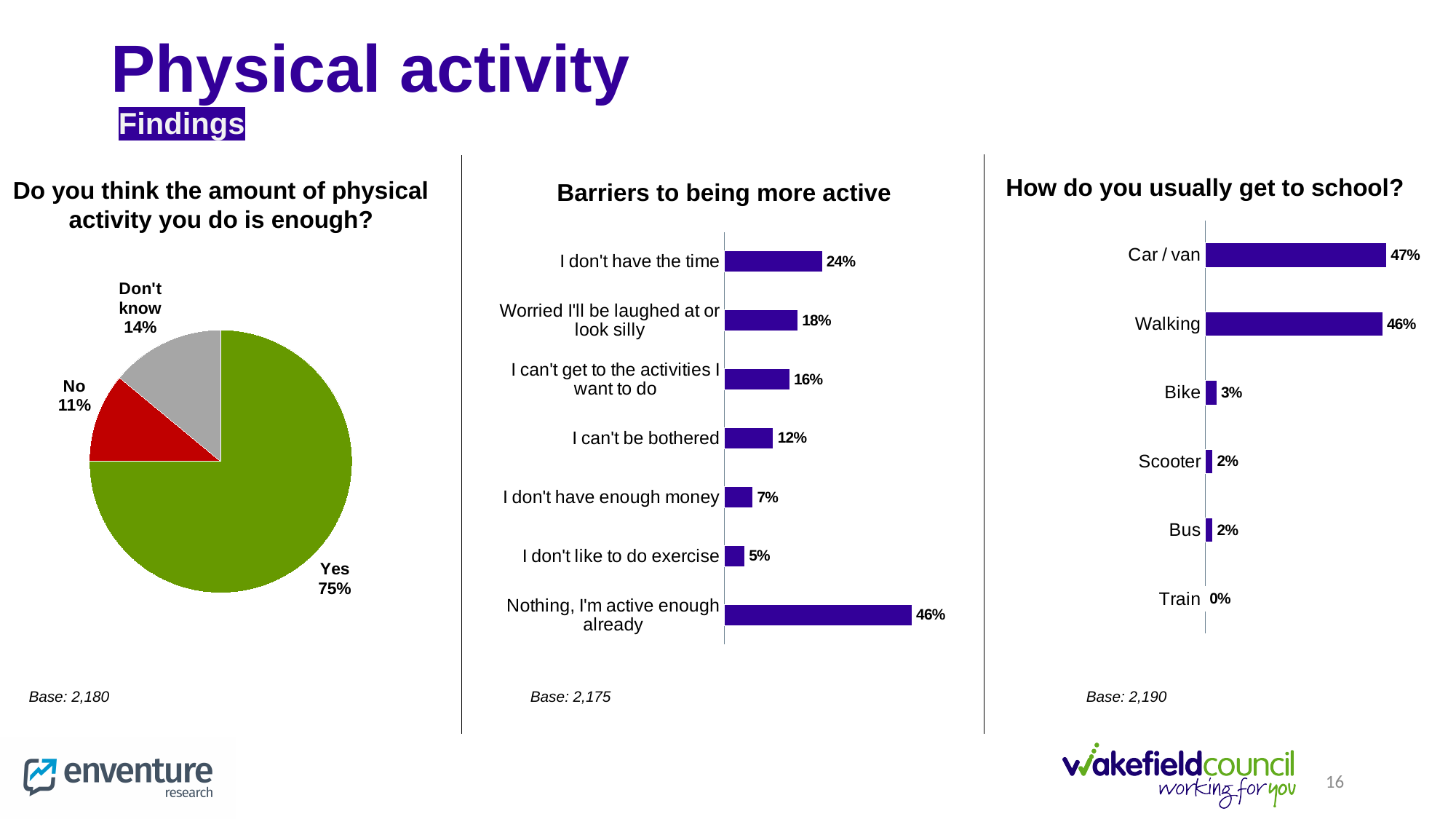
In the 'Barriers to being more active' chart, what is the difference between 'I don't have the time' and 'I can't be bothered'? 12% In the 'Do you think the amount of physical activity you do is enough?' chart, how many slices does the pie have? 3 In the 'Do you think the amount of physical activity you do is enough?' chart, what share of respondents answered Yes? 75% In the 'Do you think the amount of physical activity you do is enough?' chart, what kind of chart is shown? Pie chart In the 'Barriers to being more active' chart, what is the value for 'I don't have the time'? 24% In the 'How do you usually get to school?' chart, which mode of travel has the lowest value? Train In the 'How do you usually get to school?' chart, what kind of chart is shown? Bar chart In the 'How do you usually get to school?' chart, what is the value for Walking? 46% In the 'Barriers to being more active' chart, how many barriers are listed? 7 In the 'Do you think the amount of physical activity you do is enough?' chart, which response has the smallest slice? No In the 'How do you usually get to school?' chart, which is larger, Bike or Scooter? Bike In the 'Barriers to being more active' chart, which barrier has the highest value? Nothing, I'm active enough already